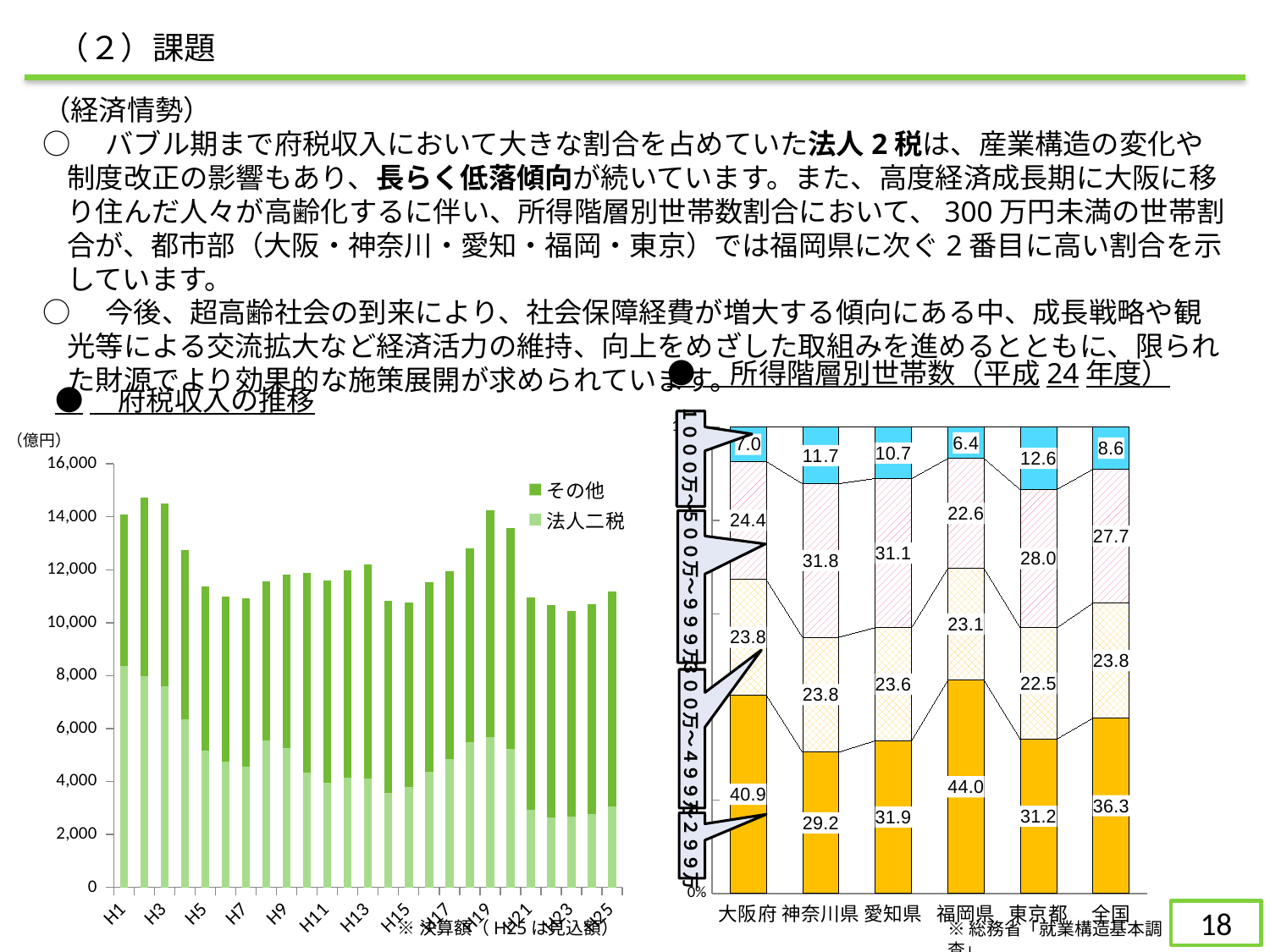
In the right chart (所得階層別世帯数（平成24年度）), what is the value of the top blue segment for 東京都? 12.6 In the right chart (所得階層別世帯数（平成24年度）), what is the value of the bottom orange segment for 大阪府? 40.9 In the left chart (府税収入の推移), is the 法人二税 value for H21 greater or less than 4,000? less In the left chart (府税収入の推移), is the total bar height for H15 greater or less than 12,000? less In the right chart (所得階層別世帯数（平成24年度）), which category has the lowest value in the top blue segment? 福岡県 In the right chart (所得階層別世帯数（平成24年度）), which has the larger value in the second-from-top hatched segment, 神奈川県 or 愛知県? 神奈川県 In the right chart (所得階層別世帯数（平成24年度）), which prefecture has the highest value in the bottom orange segment? 福岡県 In the right chart (所得階層別世帯数（平成24年度）), what is the difference between the bottom orange segment values of 福岡県 and 大阪府? 3.1 What kind of chart is the left chart (府税収入の推移)? Stacked bar chart How many series does the legend of the left chart (府税収入の推移) list? 2 How many categories are shown on the x axis of the right chart (所得階層別世帯数（平成24年度）)? 6 In the right chart (所得階層別世帯数（平成24年度）), what is the value of the second-from-top hatched segment for 全国? 27.7